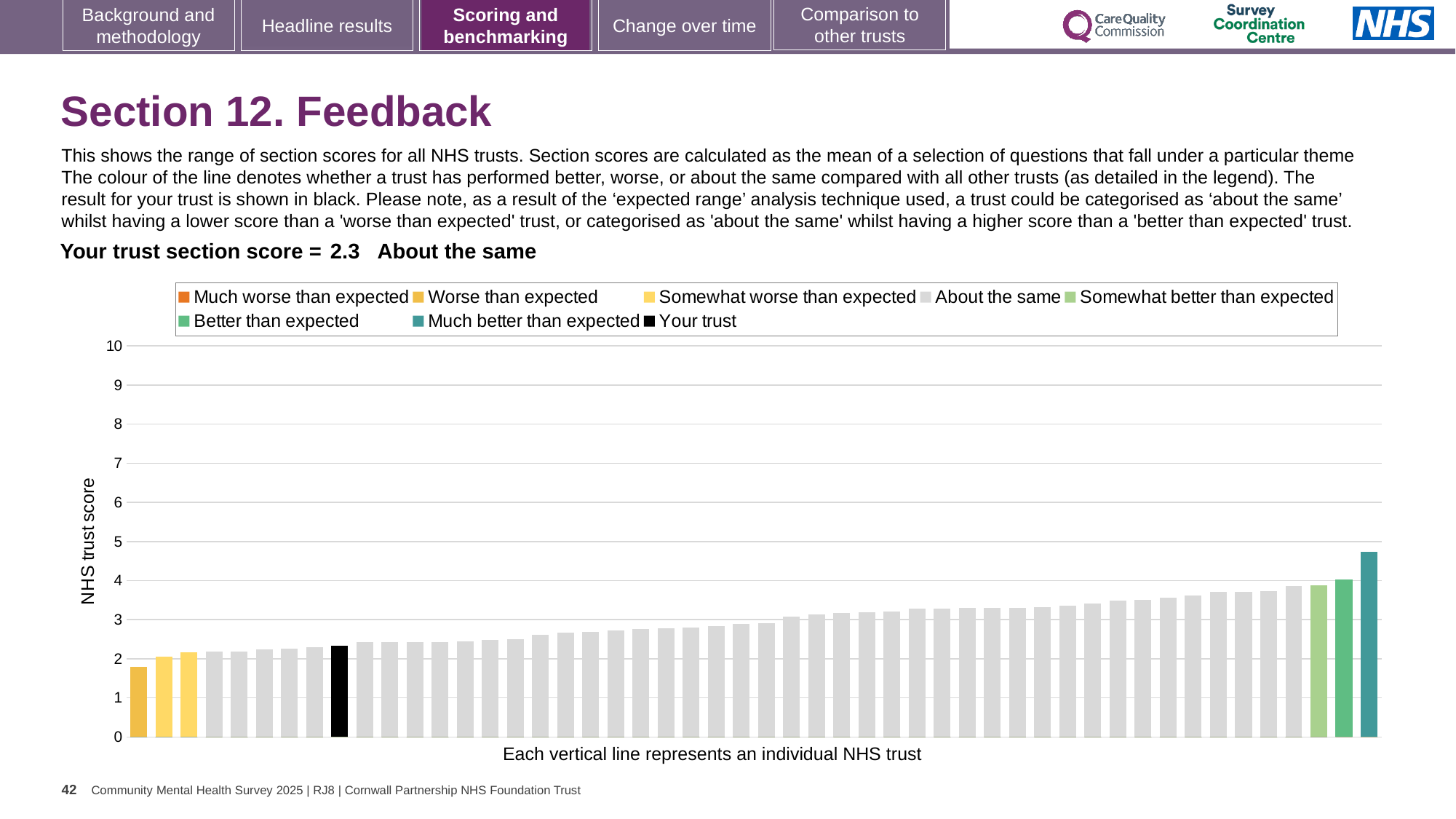
Which category is your trust's section score placed in? About the same Do the bar values rise or fall from left to right along the x axis? rise Is the value of the tallest bar (Much better than expected) greater or less than 5? less What kind of chart is shown on the slide? bar chart Is the value of the tallest bar (Much better than expected) greater or less than 4? greater How many entries does the chart legend list? 8 Which is larger: the bar for your trust or the Much better than expected bar? Much better than expected Is the value of the shortest bar (Worse than expected) greater or less than 2? less What is the section score for your trust? 2.3 How many bars are coloured as Somewhat worse than expected? 2 Which legend category does the highest bar belong to? Much better than expected